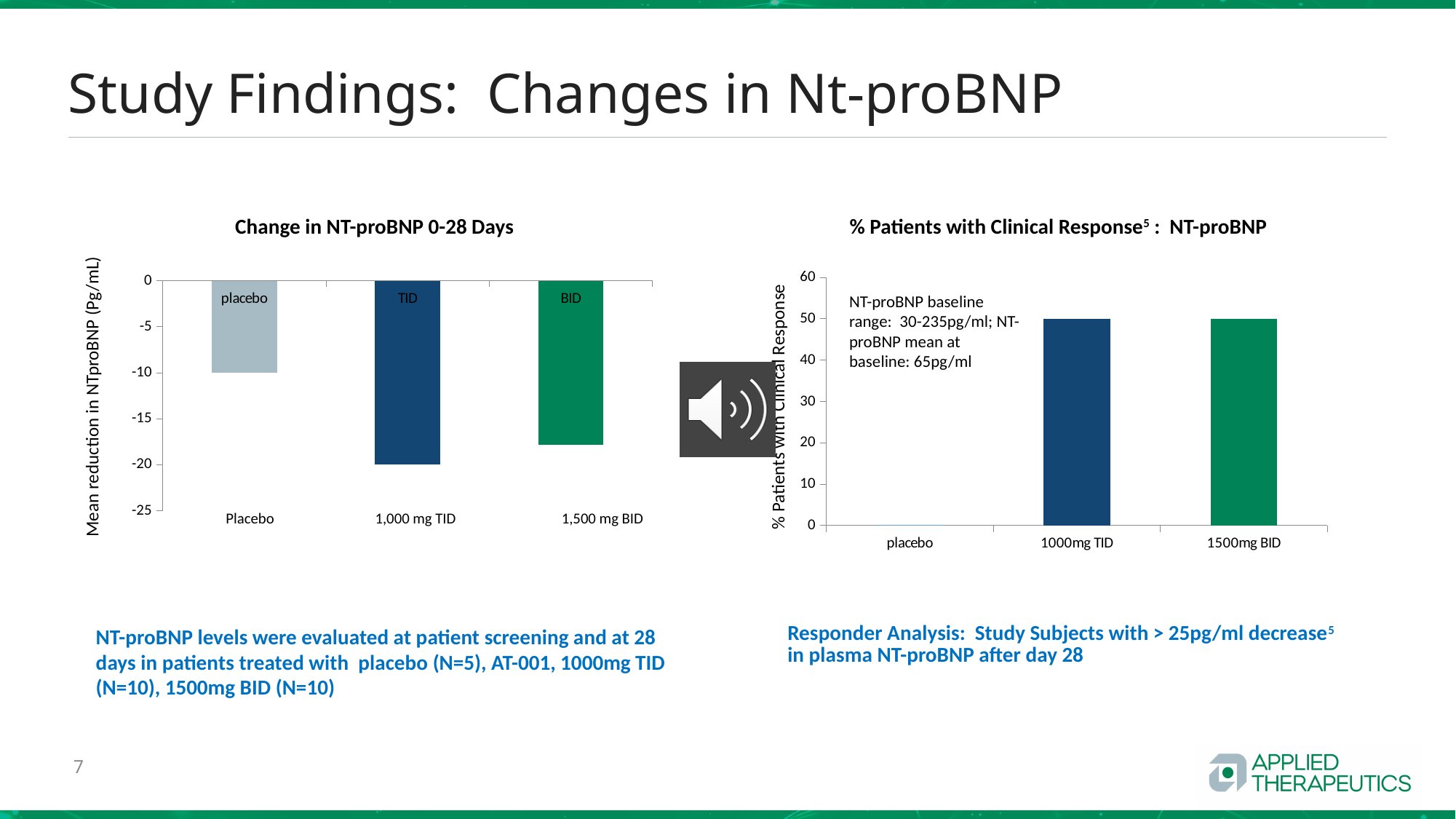
On the '% Patients with Clinical Response: NT-proBNP' chart, which category has the lowest value? placebo On the '% Patients with Clinical Response: NT-proBNP' chart, what is the value for 1500mg BID? 50 What kind of chart is the 'Change in NT-proBNP 0-28 Days' chart? bar chart On the '% Patients with Clinical Response: NT-proBNP' chart, what is the value for 1000mg TID? 50 How many categories are shown on the 'Change in NT-proBNP 0-28 Days' chart? 3 On the 'Change in NT-proBNP 0-28 Days' chart, what is the mean reduction for 1,000 mg TID? -20 How many categories are shown on the x-axis of the '% Patients with Clinical Response: NT-proBNP' chart? 3 On the 'Change in NT-proBNP 0-28 Days' chart, what is the mean reduction for Placebo? -10 On the 'Change in NT-proBNP 0-28 Days' chart, which bar extends further below zero, 1,000 mg TID or 1,500 mg BID? 1,000 mg TID On the 'Change in NT-proBNP 0-28 Days' chart, which category shows the smallest reduction (bar closest to zero)? Placebo On the 'Change in NT-proBNP 0-28 Days' chart, is the value for 1,500 mg BID greater or less than -15? less What is the y-axis label of the 'Change in NT-proBNP 0-28 Days' chart? Mean reduction in NTproBNP (Pg/mL)